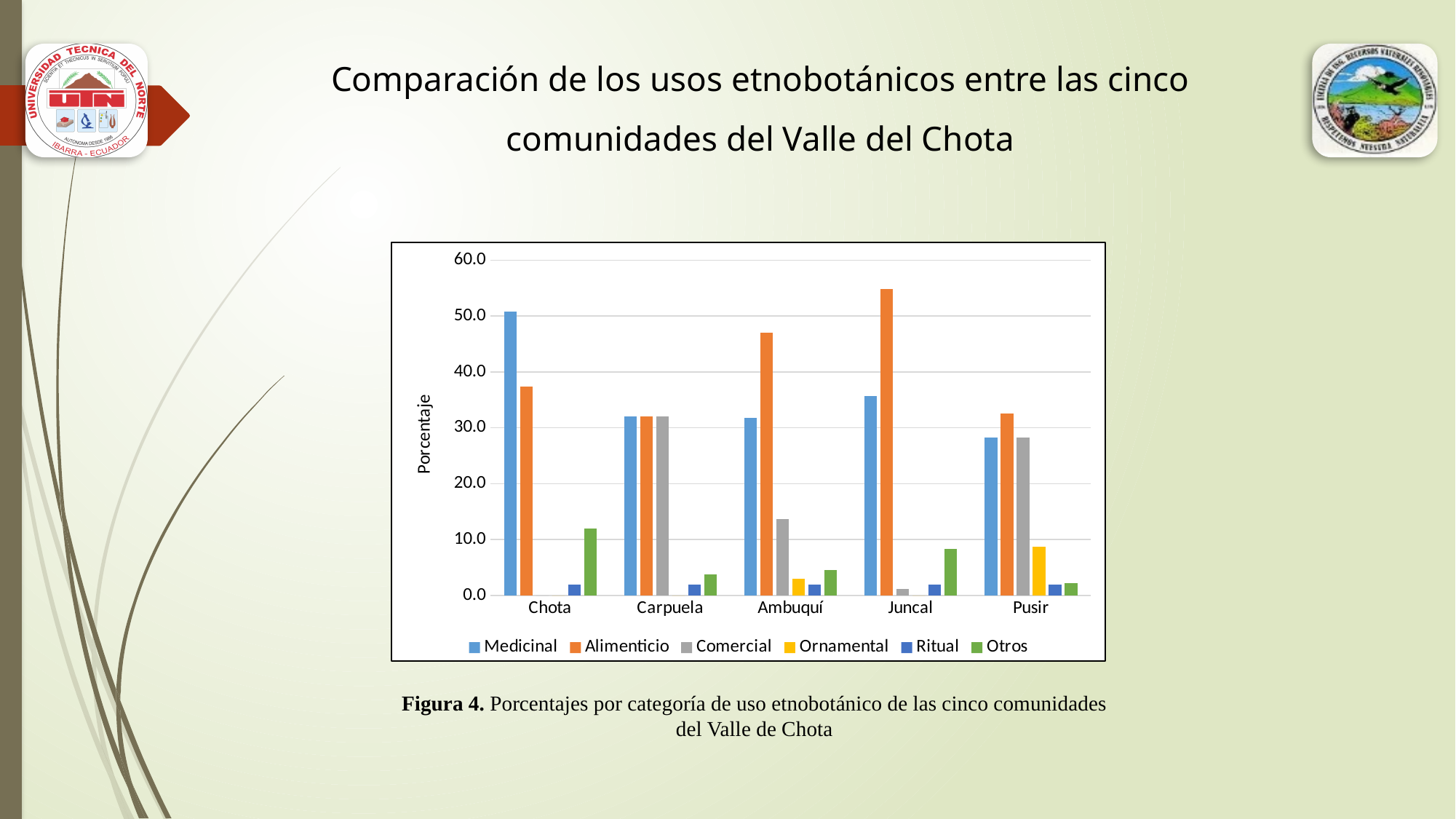
Which community has the highest Alimenticio value? Juncal Which community has the highest Medicinal value? Chota For Ambuquí, which is larger: the Medicinal value or the Alimenticio value? Alimenticio Is the Otros value for Chota greater or less than 10.0? greater Is the Alimenticio value for Juncal greater or less than 50.0? greater Is the Comercial value for Ambuquí greater or less than 20.0? less How many series does the chart legend list? 6 What kind of chart is shown on the slide? Bar chart What is the label on the y axis of the chart? Porcentaje How many communities are shown on the x axis of the chart? 5 Which community has the highest Ornamental value? Pusir